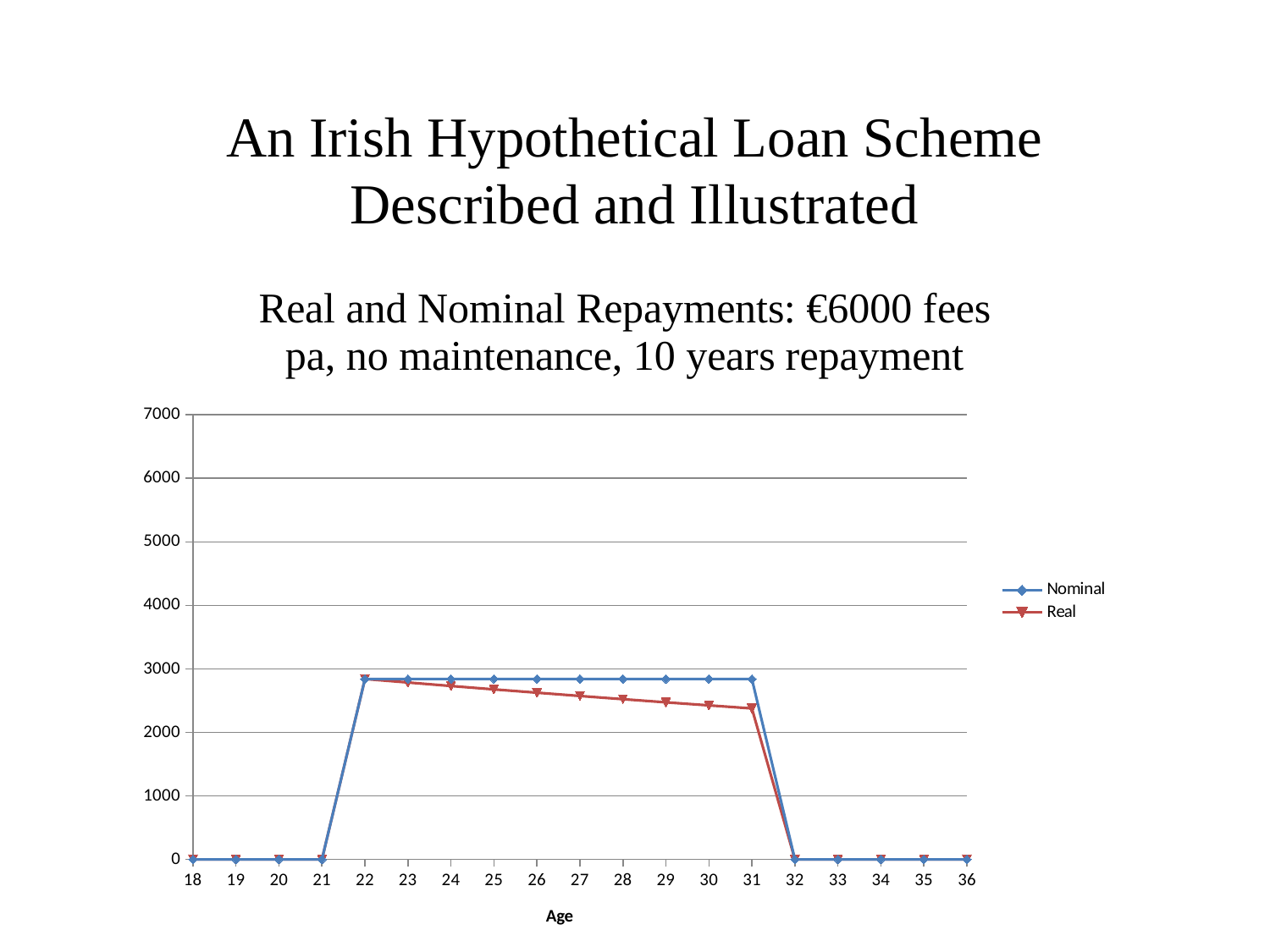
Does the Real series rise or fall between age 22 and age 31? fall Is the Real value at age 30 greater or less than 2000? greater Is the Nominal value at age 25 greater or less than 2000? greater How many series does the legend list? 2 At age 30, which series has the larger value, Nominal or Real? Nominal How many age points are plotted along the x axis? 19 What is the Real repayment value at age 36? 0 What is the Nominal repayment value at age 18? 0 What kind of chart is shown on the slide? line chart What is the title of the x axis? Age Is the Real value at age 31 greater or less than 3000? less What are the two entries in the legend? Nominal, Real